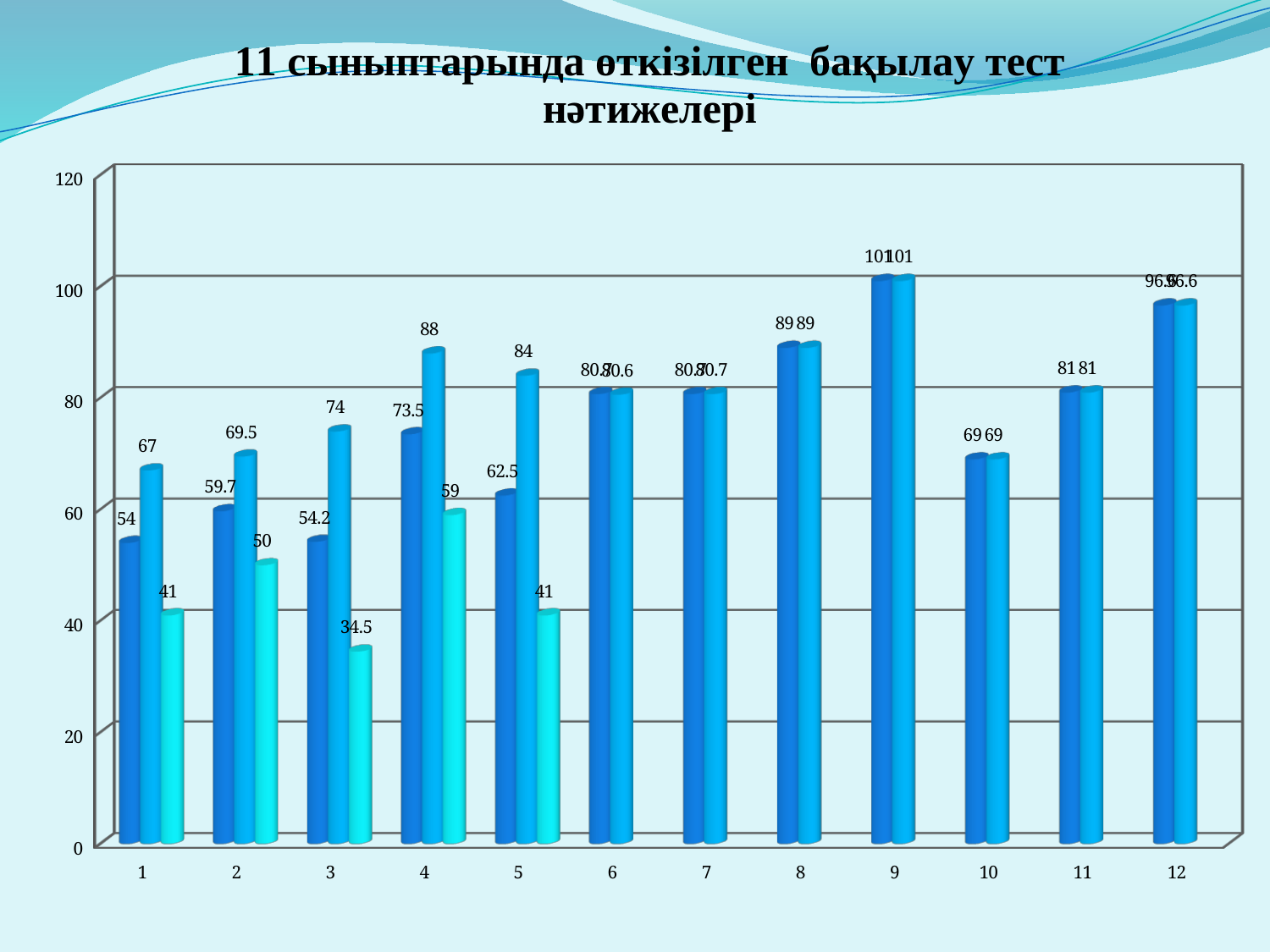
How many categories have a light cyan (third) bar? 5 Among the light cyan (third) bars, which category has the lowest value? 3 What is the value of the bars for category 9? 101 What is the value of the first (dark blue) bar for category 1? 54 How many categories are shown on the x axis? 12 What is the value of the middle (medium blue) bar for category 4? 88 For category 1, what is the difference between the middle bar (67) and the light cyan bar (41)? 26 What kind of chart is shown on the slide? bar chart Which is larger: the middle (medium blue) bar for category 2 or for category 3? category 3 What is the value of the light cyan (third) bar for category 3? 34.5 Which category has the tallest bars on the chart? 9 Are the bars for category 10 greater or less than 80? less